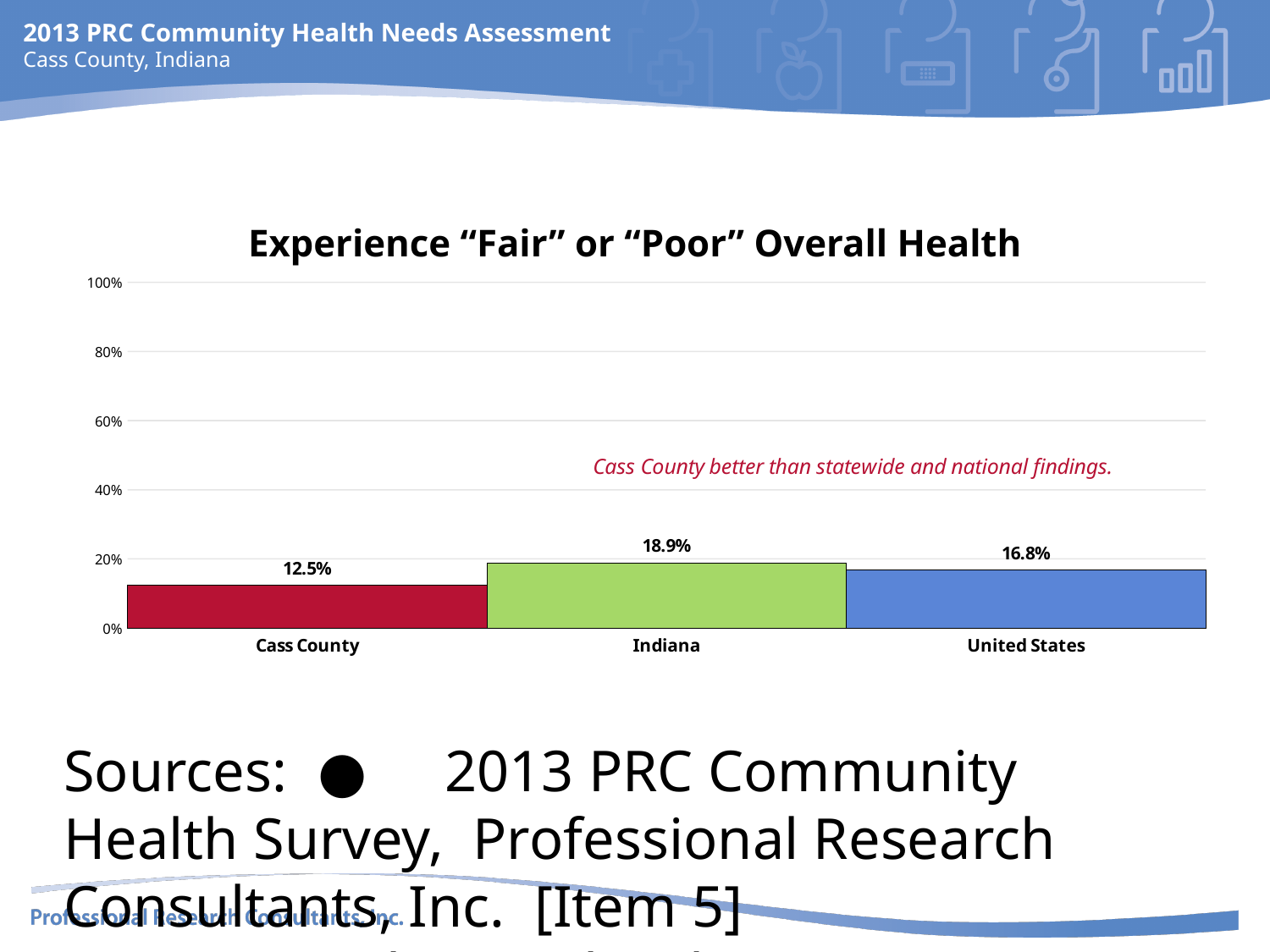
Which is larger, the value for United States or the value for Cass County? United States What is the value for Cass County? 12.5% What is the title of the chart? Experience "Fair" or "Poor" Overall Health Which category has the highest value? Indiana Is the value for Indiana greater or less than 20%? less What is the difference between the Indiana and Cass County values? 6.4% What is the difference between the Indiana and United States values? 2.1% How many categories are shown on the chart? 3 What is the value for United States? 16.8% What kind of chart is shown on the slide? bar chart Which category has the lowest value? Cass County What is the value for Indiana? 18.9%